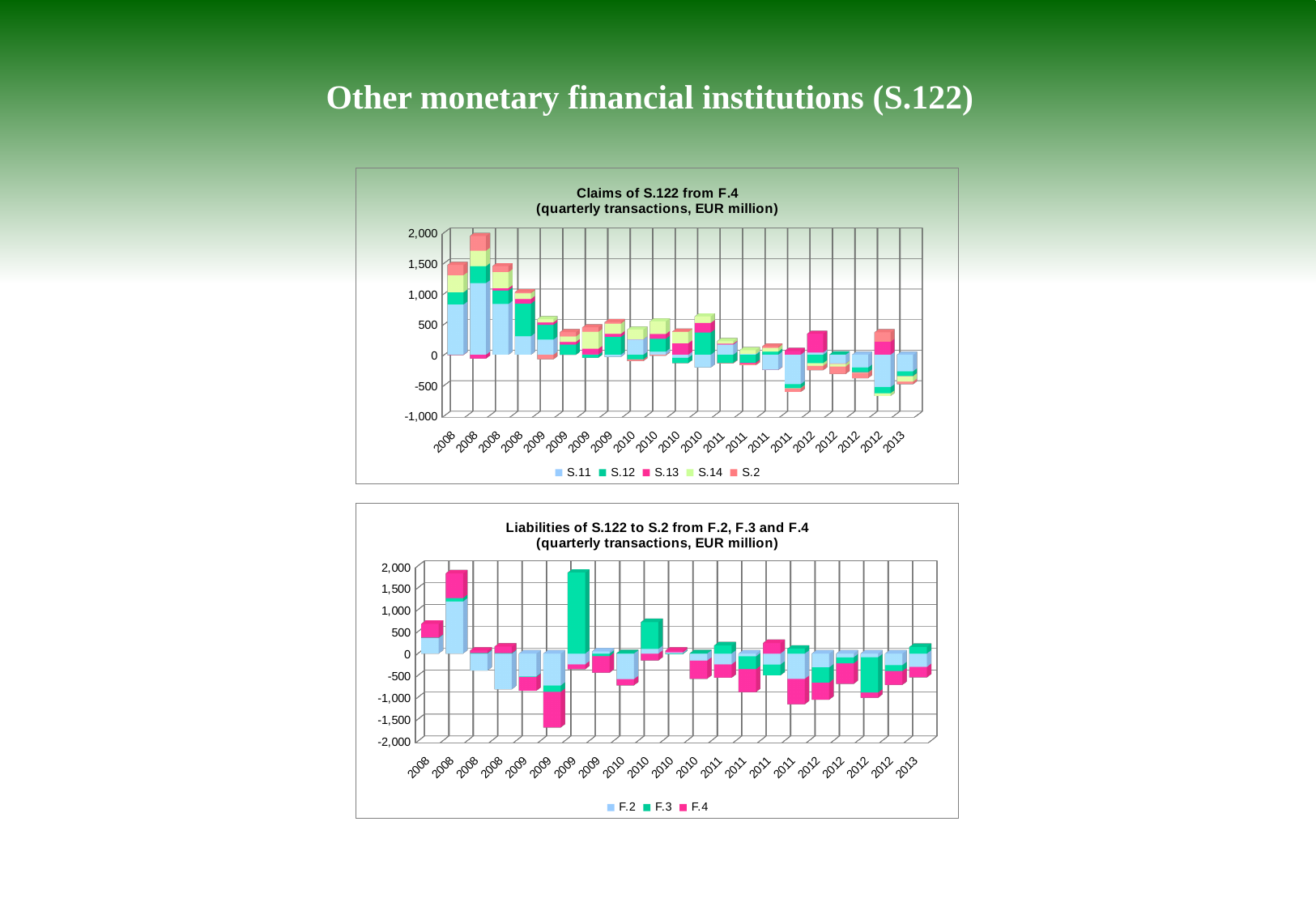
How many series does the legend of the top chart 'Claims of S.122 from F.4' list? 5 How many bars are plotted in the top chart 'Claims of S.122 from F.4'? 21 What is the lowest value shown on the vertical axis of the bottom chart 'Liabilities of S.122 to S.2 from F.2, F.3 and F.4'? -2,000 How many series does the legend of the bottom chart 'Liabilities of S.122 to S.2 from F.2, F.3 and F.4' list? 3 In the bottom chart 'Liabilities of S.122 to S.2 from F.2, F.3 and F.4', is the bottom of the second 2009 bar greater or less than -1,500? less Which series are listed in the legend of the top chart 'Claims of S.122 from F.4'? S.11, S.12, S.13, S.14, S.2 In the bottom chart 'Liabilities of S.122 to S.2 from F.2, F.3 and F.4', is the top of the third 2009 bar greater or less than 1,500? greater How many bars are plotted in the bottom chart 'Liabilities of S.122 to S.2 from F.2, F.3 and F.4'? 21 In the top chart 'Claims of S.122 from F.4', what unit is stated in the title for the quarterly transactions? EUR million In the top chart 'Claims of S.122 from F.4', is the top of the second 2008 bar greater or less than 1,500? greater What kind of chart is the top chart, 'Claims of S.122 from F.4'? Stacked bar chart What kind of chart is the bottom chart, 'Liabilities of S.122 to S.2 from F.2, F.3 and F.4'? Stacked bar chart